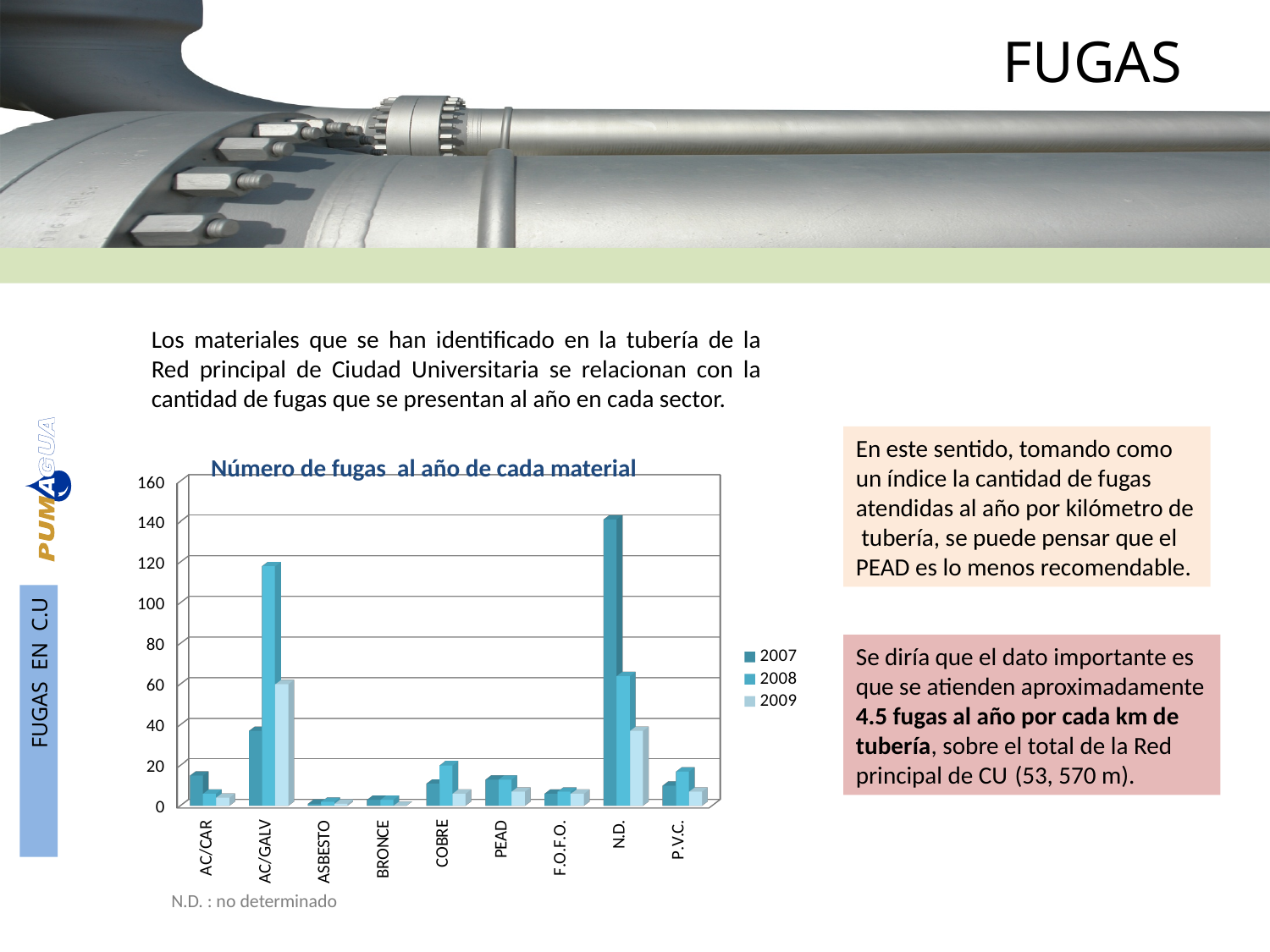
Which material has the highest value for 2007? N.D. Which is larger for 2007: the value for N.D. or the value for AC/GALV? N.D. What is the title of the chart? Número de fugas al año de cada material Which material has the highest value for 2008? AC/GALV Is the 2007 value for N.D. greater or less than 120? greater Is the 2008 value for AC/GALV greater or less than 100? greater Which is larger for 2008: the value for AC/GALV or the value for N.D.? AC/GALV Is the 2009 value for AC/GALV greater or less than 80? less How many material categories are shown on the x axis of the chart? 9 How many series does the chart legend list? 3 What kind of chart is shown on the slide? bar chart Which years are listed in the chart legend? 2007, 2008, 2009